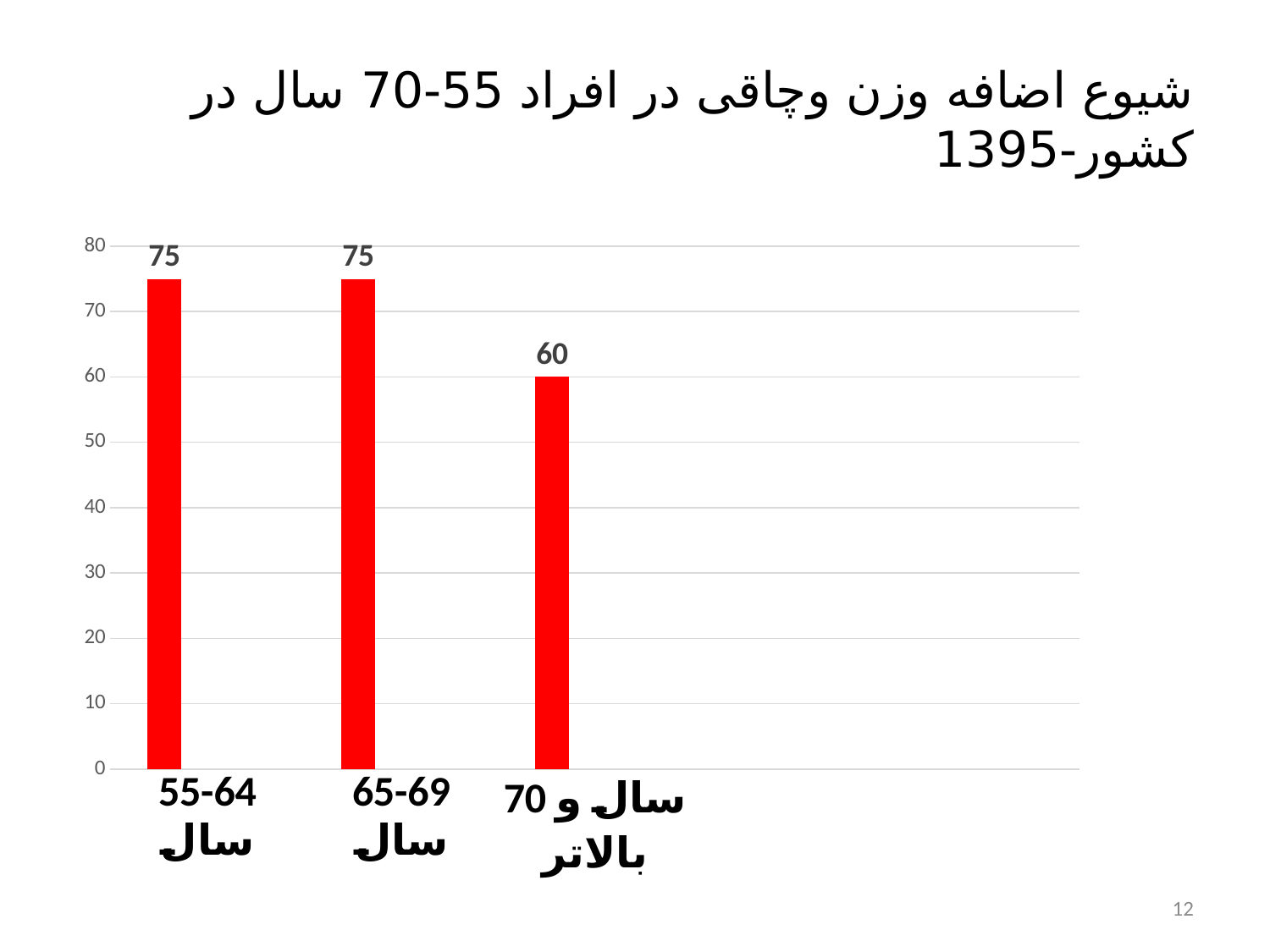
What is the value for the 55-64 سال category? 75 What kind of chart is shown on the slide? bar chart How many categories are shown on the x axis? 3 Is the value for 55-64 سال greater or less than 70? greater What colour are the bars in the chart? red What is the value for the 70 سال و بالاتر category? 60 Do the values rise or fall from the first category to the last along the x axis? fall Which category has the lowest value? 70 سال و بالاتر What is the value for the 65-69 سال category? 75 Which is larger, the value for 65-69 سال or the value for 70 سال و بالاتر? 65-69 سال What is the difference between the values for 55-64 سال and 70 سال و بالاتر? 15 Is the value for 70 سال و بالاتر greater or less than 70? less